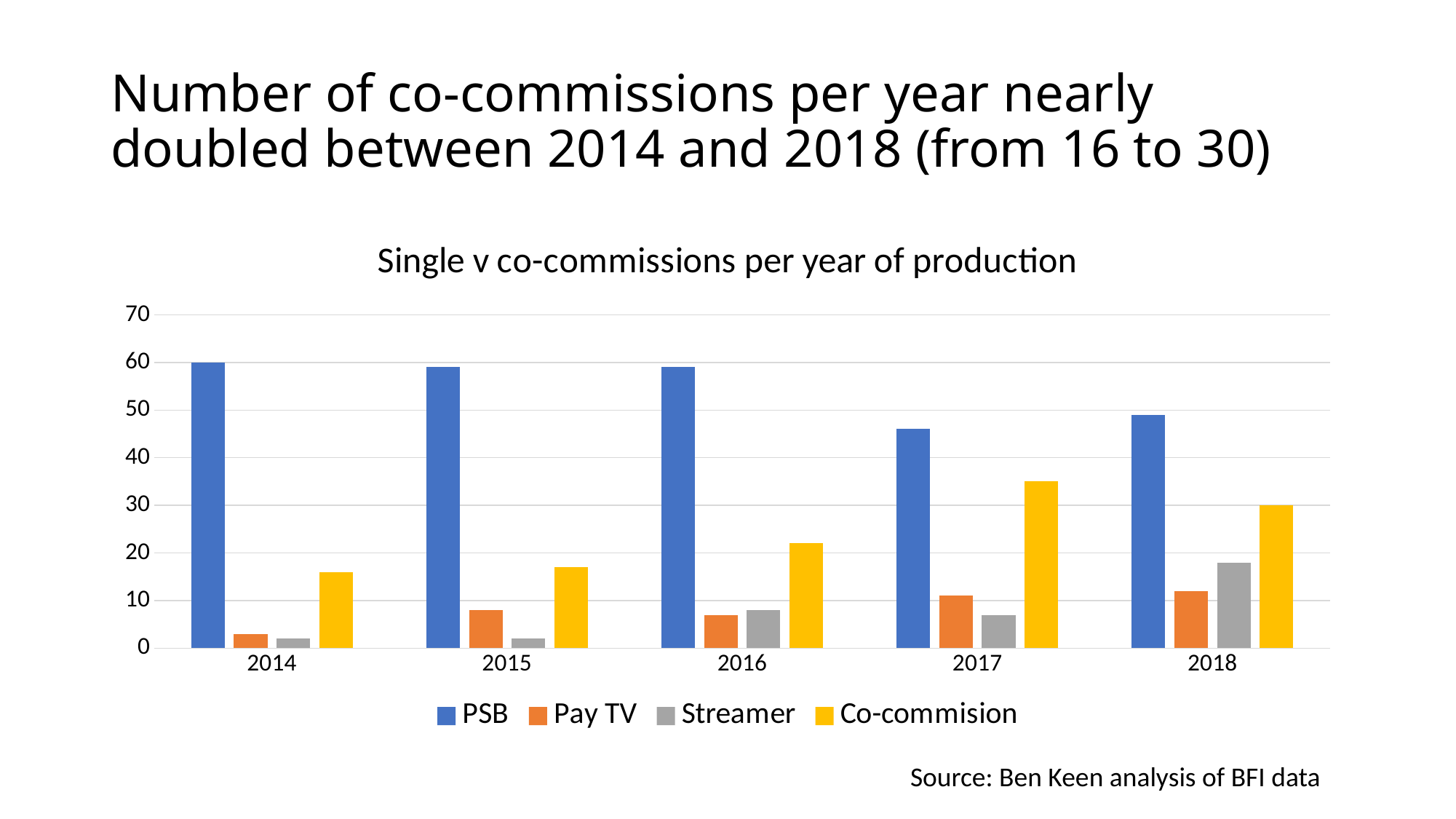
How many series does the legend list? 4 In which year is the Streamer value highest? 2018 What kind of chart is shown on the slide? bar chart What is the Co-commision value for 2018? 30 How many years are shown on the x axis? 5 Which is larger, the PSB value for 2014 or the PSB value for 2017? 2014 Does the Co-commision series rise or fall from 2014 to 2017? rise Is the Streamer value for 2018 greater or less than 20? less What is the PSB value for 2014? 60 What is the title of the chart? Single v co-commissions per year of production In which year is the Co-commision value highest? 2017 Is the PSB value for 2017 greater or less than 40? greater